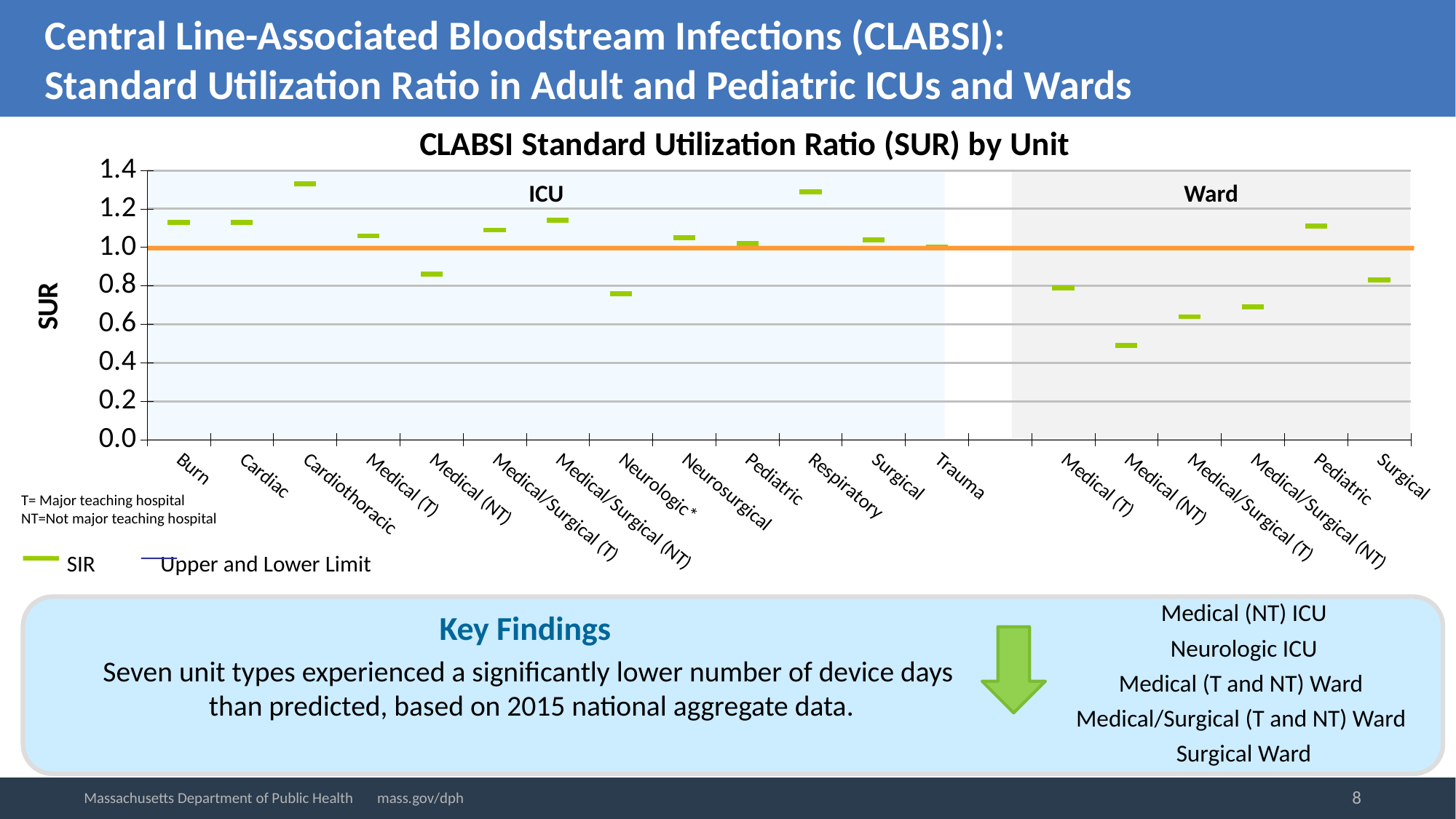
How many unit types are plotted in the ICU section of the chart? 13 Which has the larger SUR value, the Neurologic ICU or the Medical (T) ICU? Medical (T) ICU Is the SUR value for the Cardiothoracic ICU greater or less than 1.2? greater Is the SUR value for the Pediatric Ward greater or less than 1.0? greater How many series does the chart legend list? 2 Is the SUR value for the Medical (NT) Ward greater or less than 0.6? less Which has the larger SUR value, the Cardiothoracic ICU or the Medical (NT) ICU? Cardiothoracic ICU How many unit types are plotted in the Ward section of the chart? 6 Which unit has the lowest SUR value on the chart? Medical (NT) Ward Which has the larger SUR value, the Pediatric Ward or the Surgical Ward? Pediatric Ward